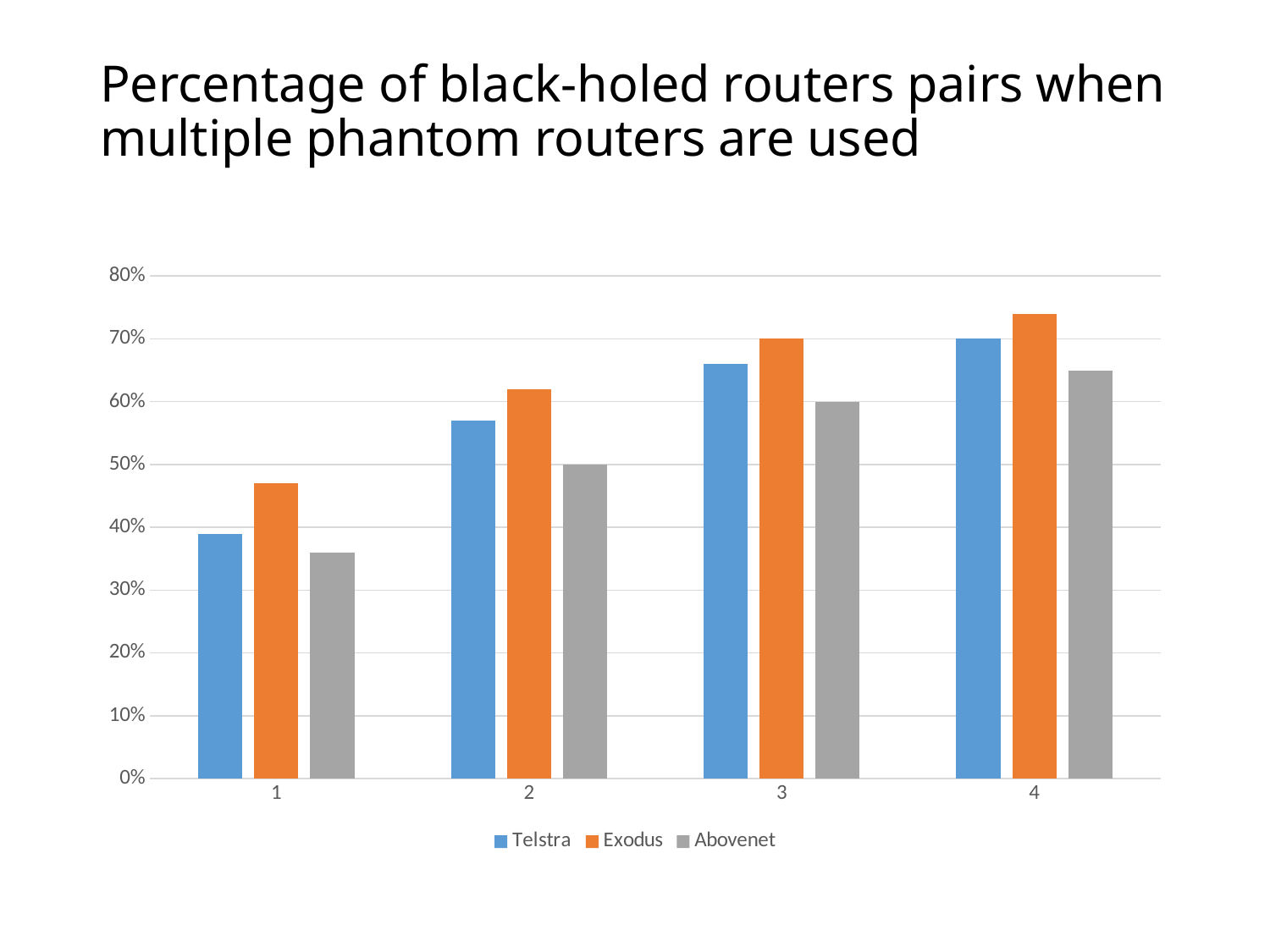
What is the title of the chart on the slide? Percentage of black-holed routers pairs when multiple phantom routers are used Which series has the highest bar at category 4? Exodus What type of chart is shown on the slide? bar chart Is the value for Telstra at category 1 greater or less than 40%? less How many categories are shown on the x axis? 4 How many series does the legend list? 3 Is the value for Abovenet at category 4 greater or less than 60%? greater Is the value for Exodus at category 2 greater or less than 60%? greater Which series has the lowest bar at category 1? Abovenet Which is larger at category 3, Telstra or Abovenet? Telstra Do the Telstra values rise or fall as the category number increases from 1 to 4? rise